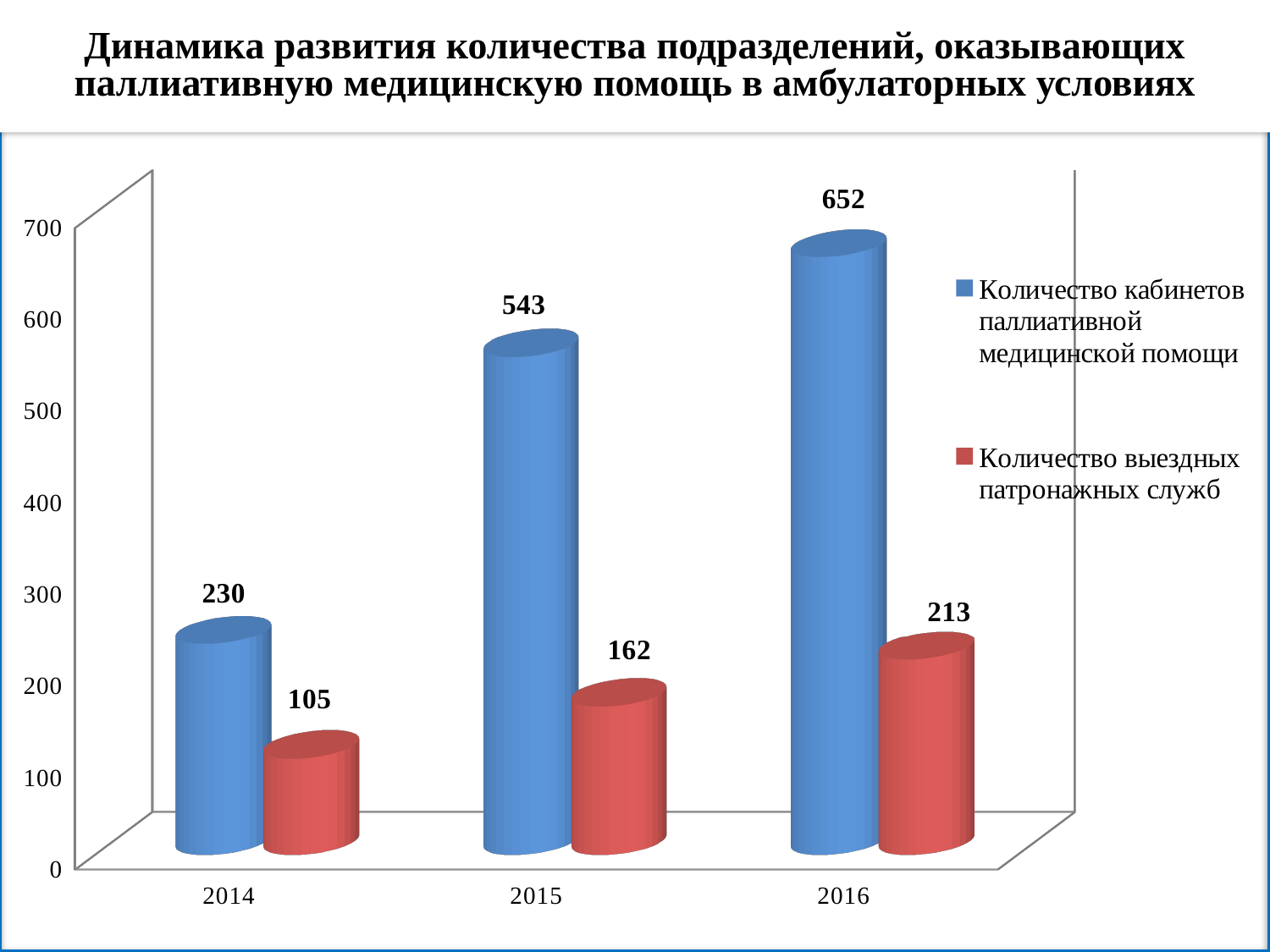
Which is larger: 'Количество кабинетов паллиативной медицинской помощи' in 2014 or 'Количество выездных патронажных служб' in 2016? Количество кабинетов паллиативной медицинской помощи in 2014 How many years are shown on the x axis? 3 What is the difference between 'Количество кабинетов паллиативной медицинской помощи' in 2016 and in 2014? 422 In which year is 'Количество кабинетов паллиативной медицинской помощи' highest? 2016 What is the value for 'Количество выездных патронажных служб' in 2016? 213 In which year is 'Количество выездных патронажных служб' lowest? 2014 What is the difference between 'Количество выездных патронажных служб' in 2016 and in 2015? 51 Do the values for 'Количество кабинетов паллиативной медицинской помощи' rise or fall from 2014 to 2016? Rise What kind of chart is shown on the slide? Bar chart What is the value for 'Количество кабинетов паллиативной медицинской помощи' in 2015? 543 What is the value for 'Количество выездных патронажных служб' in 2014? 105 How many series does the legend list? 2